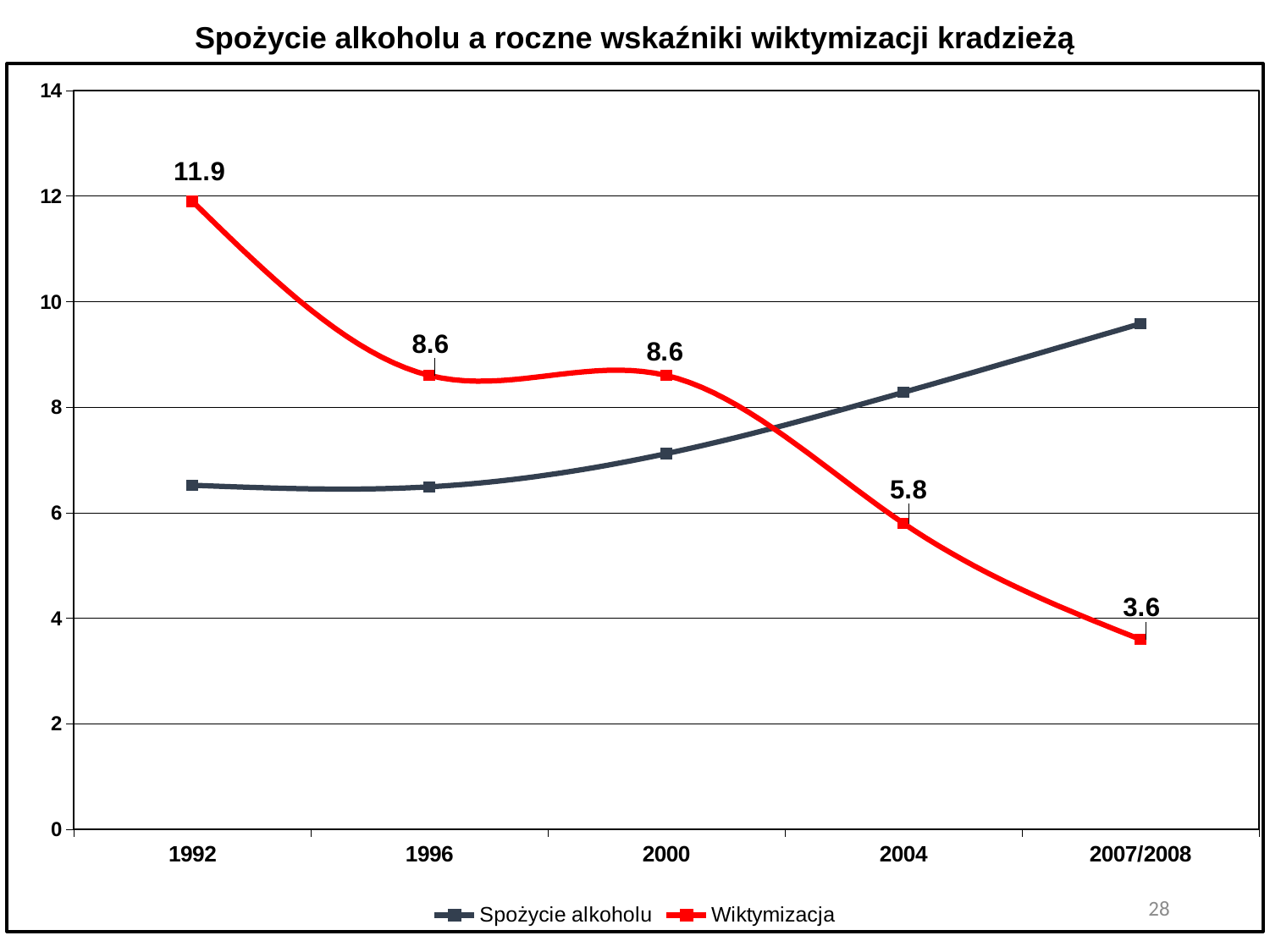
How many time points are shown on the x axis? 5 What is the Wiktymizacja value for 2007/2008? 3.6 In which year is the Wiktymizacja value highest? 1992 Is the Spożycie alkoholu value for 1992 greater or less than 8? less In which year is the Wiktymizacja value lowest? 2007/2008 What is the difference between the Wiktymizacja values for 1992 and 2007/2008? 8.3 Does the Spożycie alkoholu series rise or fall from 1992 to 2007/2008? rise How many series does the legend list? 2 Does the Wiktymizacja series rise or fall from 1992 to 2007/2008? fall What is the Wiktymizacja value for 1992? 11.9 Is the Spożycie alkoholu value for 2007/2008 greater or less than 8? greater What is the Wiktymizacja value for 2004? 5.8